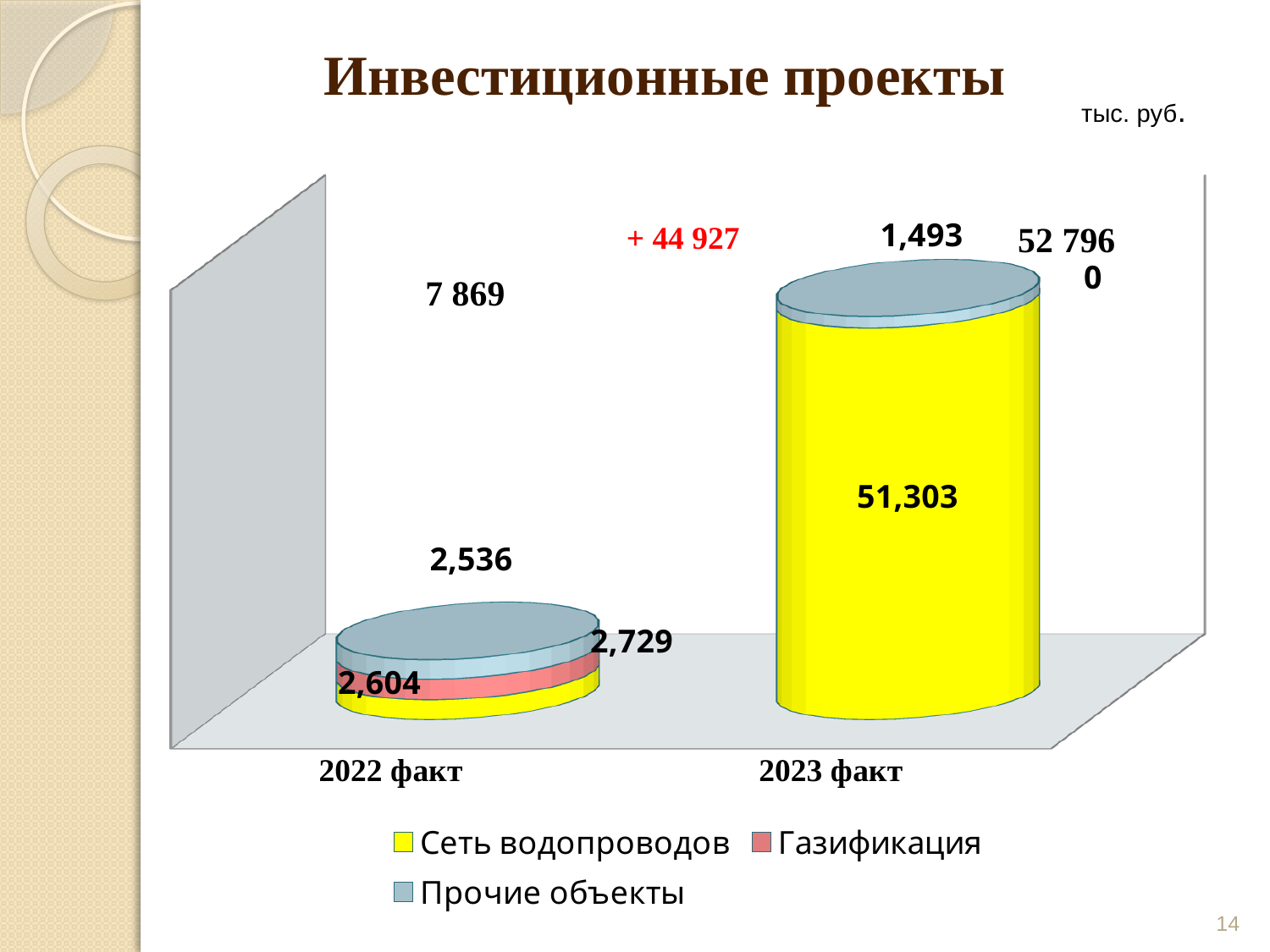
What is the total shown for the 2022 факт bar? 7 869 What is the value of Сеть водопроводов for 2022 факт? 2,604 How many categories are shown on the x axis? 2 What type of chart is shown on the slide? bar chart What is the value of Сеть водопроводов for 2023 факт? 51,303 How many series does the legend list? 3 What is the value of Прочие объекты for 2023 факт? 1,493 Which category has the higher value for Сеть водопроводов, 2022 факт or 2023 факт? 2023 факт What is the total shown for the 2023 факт bar? 52 796 What is the value of Газификация for 2022 факт? 2,729 What is the title of the chart? Инвестиционные проекты What is the value of Прочие объекты for 2022 факт? 2,536